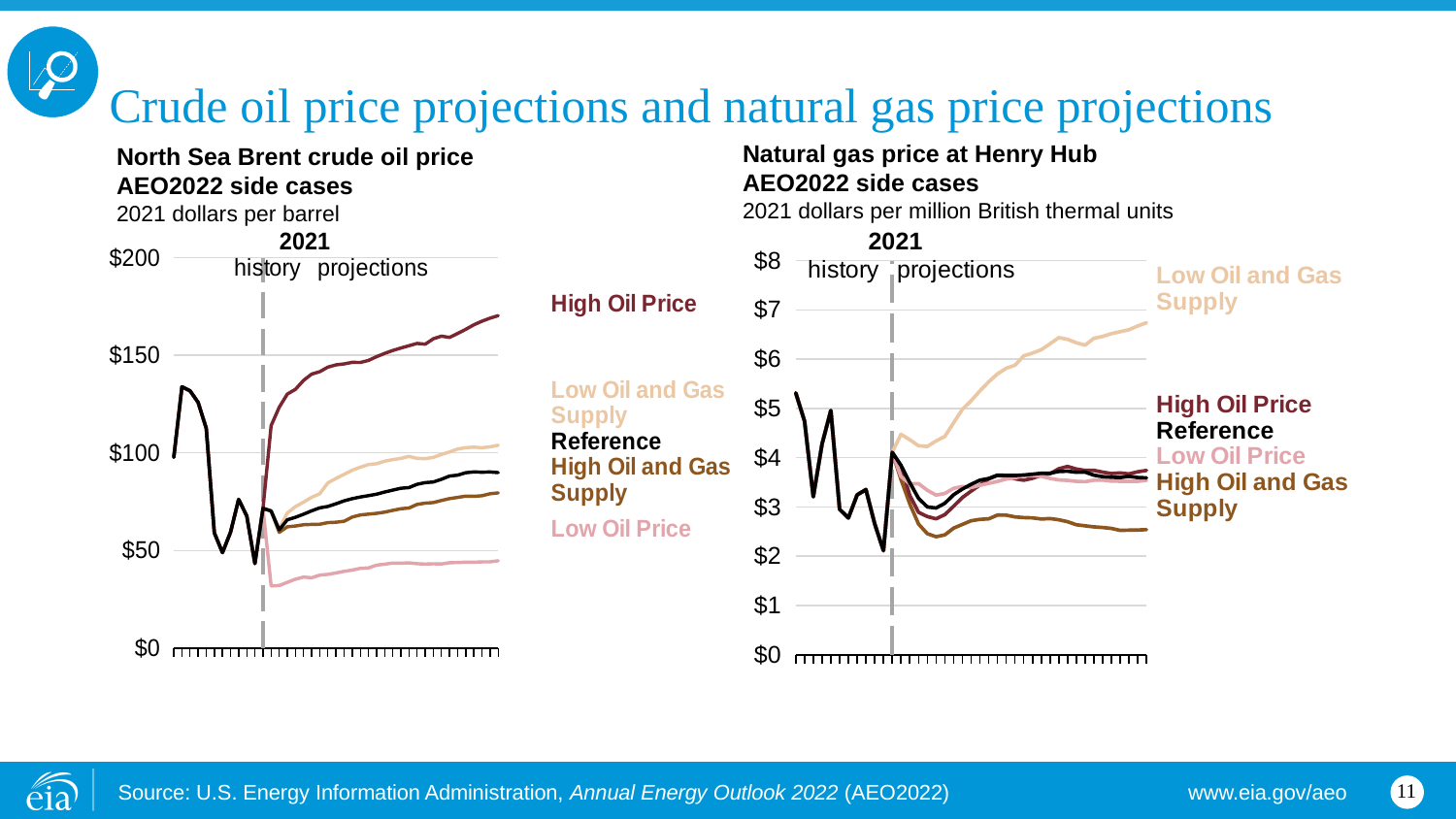
On the Natural gas price at Henry Hub chart, is the High Oil and Gas Supply value at the end of the projections greater or less than $3? less What units are used on the Natural gas price at Henry Hub chart? 2021 dollars per million British thermal units On the Natural gas price at Henry Hub chart, which side case has the lowest price at the end of the projection period? High Oil and Gas Supply On the North Sea Brent crude oil price chart, which side case has the highest price at the end of the projection period? High Oil Price On the Natural gas price at Henry Hub chart, which side case has the highest price at the end of the projection period? Low Oil and Gas Supply On the Natural gas price at Henry Hub chart, is the Low Oil and Gas Supply value at the end of the projections greater or less than $6? greater How many side cases (series) are plotted on the Natural gas price at Henry Hub chart? 5 On the North Sea Brent crude oil price chart, is the Low Oil Price value at the end of the projections greater or less than $50? less On the North Sea Brent crude oil price chart, does the High Oil Price line rise or fall over the projection period? rise On the North Sea Brent crude oil price chart, which side case has the lowest price at the end of the projection period? Low Oil Price What type of chart is the North Sea Brent crude oil price chart? line chart